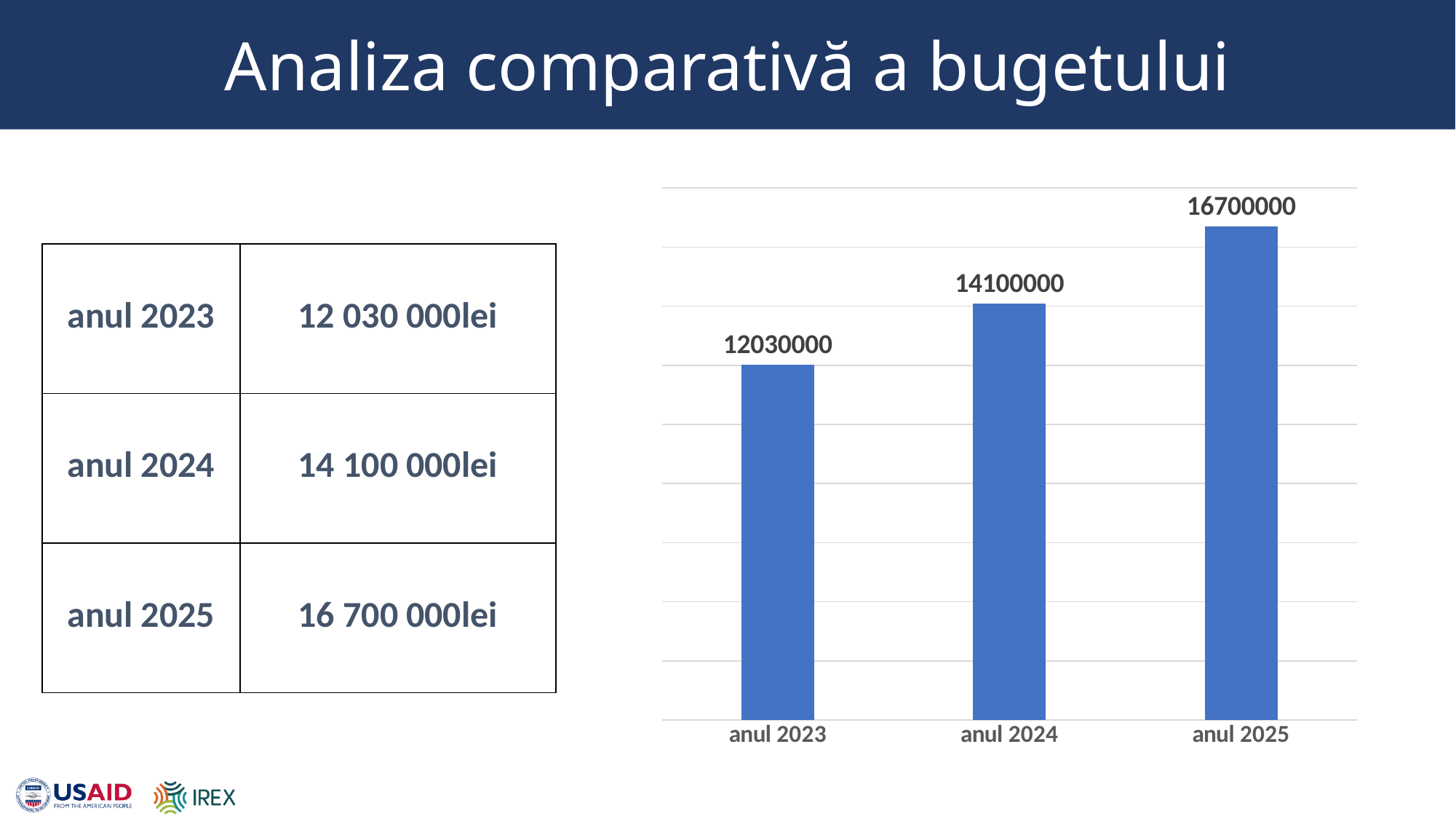
Which year has the lowest value in the bar chart? anul 2023 How many bars are shown in the chart? 3 Which is larger in the bar chart, the value for anul 2023 or the value for anul 2024? anul 2024 What colour are the bars in the chart? blue Which year has the highest value in the bar chart? anul 2025 What kind of chart is shown on the slide? bar chart What is the difference between the values for anul 2025 and anul 2024 in the bar chart? 2600000 What is the difference between the values for anul 2024 and anul 2023 in the bar chart? 2070000 What is the value shown for anul 2023 in the bar chart? 12030000 What is the value shown for anul 2024 in the bar chart? 14100000 Do the values in the bar chart rise or fall from anul 2023 to anul 2025? rise What is the value shown for anul 2025 in the bar chart? 16700000